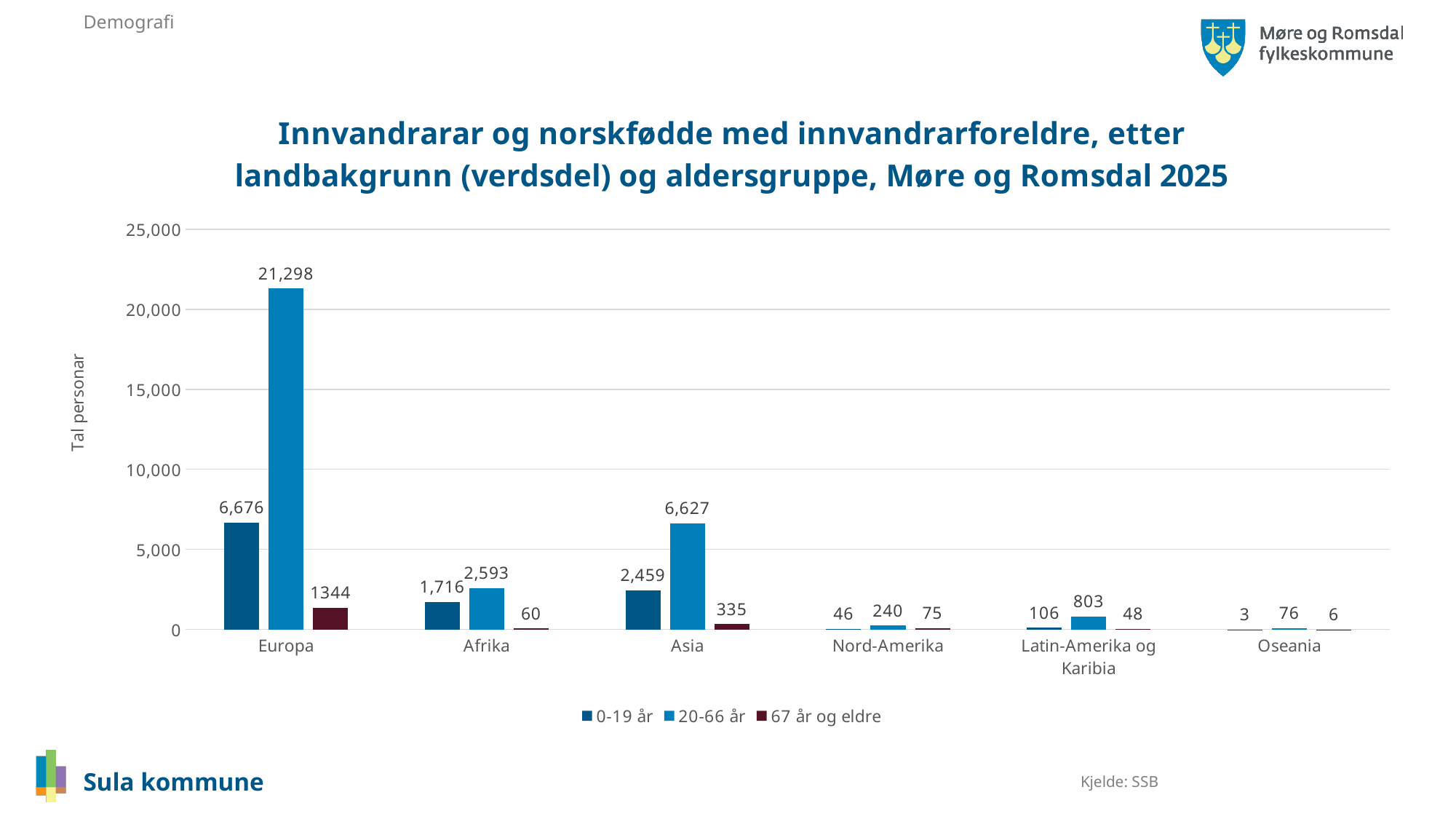
What is the value for the 0-19 år series for Latin-Amerika og Karibia? 106 Is the 20-66 år value for Europa greater or less than 20,000? greater How many categories are shown on the x axis? 6 Which is larger for Afrika: the 0-19 år value or the 20-66 år value? 20-66 år Which category has the highest value in the 20-66 år series? Europa What is the label of the y axis? Tal personar What is the value for the 67 år og eldre series for Asia? 335 What is the difference between the 0-19 år values for Europa and Asia? 4,217 What is the value for the 20-66 år series for Europa? 21,298 How many series does the legend list? 3 Which category has the lowest value in the 0-19 år series? Oseania What kind of chart is shown on the slide? Bar chart